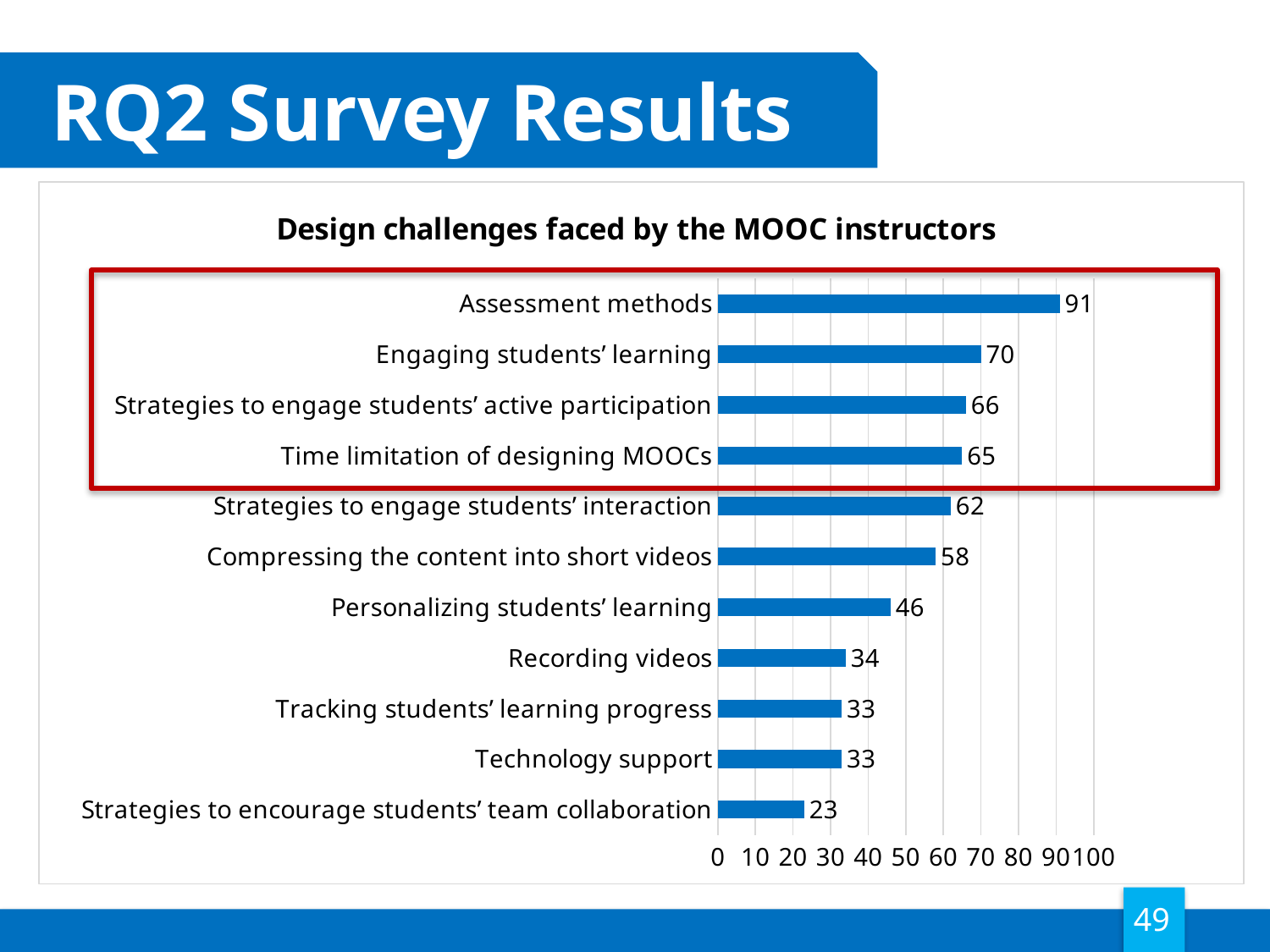
What is the value for Strategies to encourage students' team collaboration? 23 What kind of chart is shown on the slide? bar chart Is the value for Recording videos greater or less than 40? less How many design challenges are shown in the chart? 11 What is the title of the chart? Design challenges faced by the MOOC instructors Which design challenge has the lowest value? Strategies to encourage students' team collaboration What is the difference between the values for Assessment methods and Engaging students' learning? 21 What is the difference between the values for Compressing the content into short videos and Recording videos? 24 What is the value for Assessment methods? 91 Which design challenge has the highest value? Assessment methods Which is larger, the value for Time limitation of designing MOOCs or the value for Strategies to engage students' interaction? Time limitation of designing MOOCs What is the value for Personalizing students' learning? 46